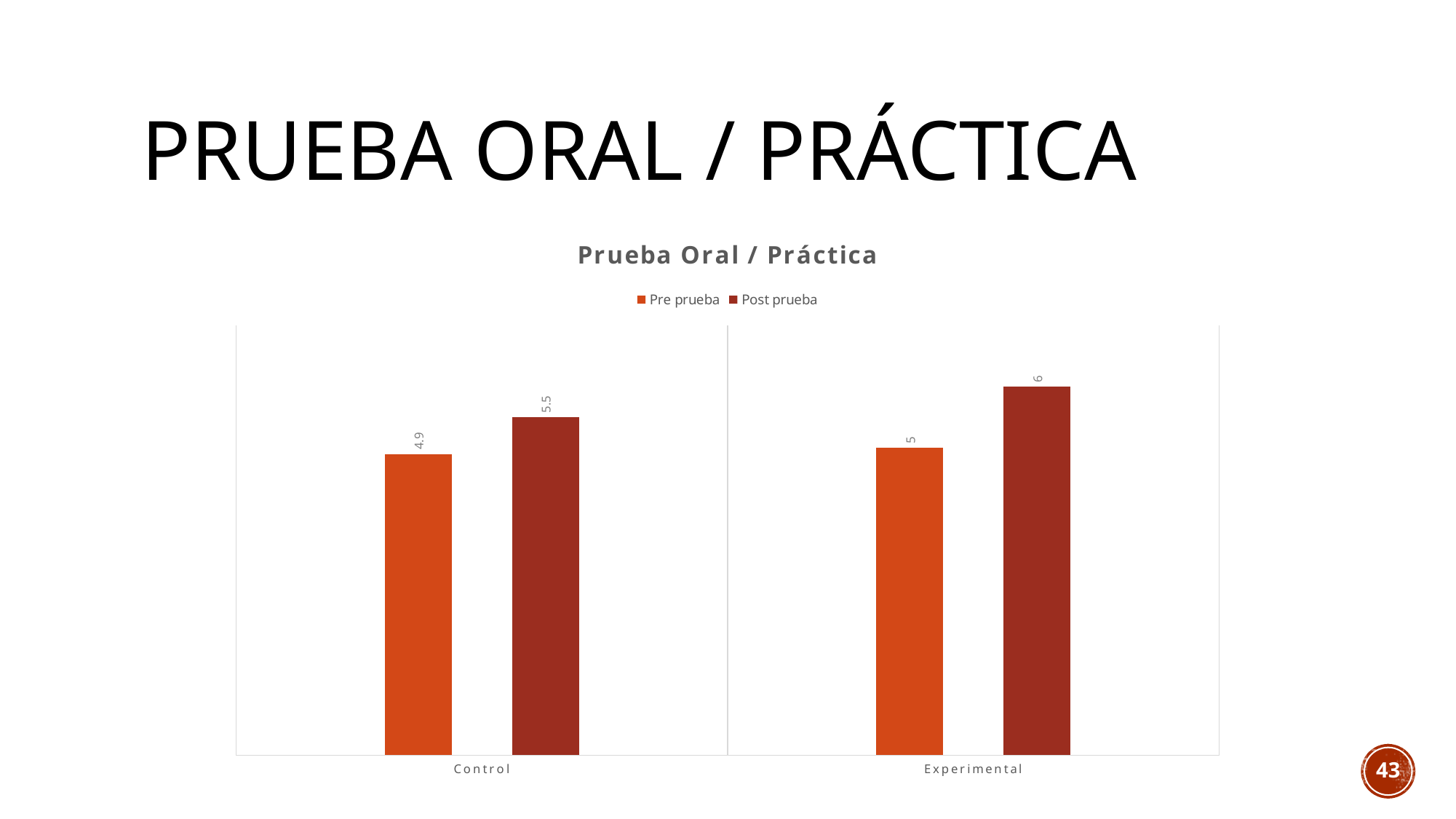
What is the Post prueba value for Experimental? 6 What is the Post prueba value for Control? 5.5 How many groups are shown on the x axis? 2 What kind of chart is shown on the slide? Bar chart What is the Pre prueba value for Experimental? 5 What is the Pre prueba value for Control? 4.9 How many series does the legend list? 2 What is the difference between the Post prueba and Pre prueba values for Control? 0.6 Which group has the lowest Pre prueba value? Control Which group has the highest Post prueba value? Experimental Which is larger: the Post prueba value for Control or the Post prueba value for Experimental? Experimental What is the difference between the Post prueba and Pre prueba values for Experimental? 1